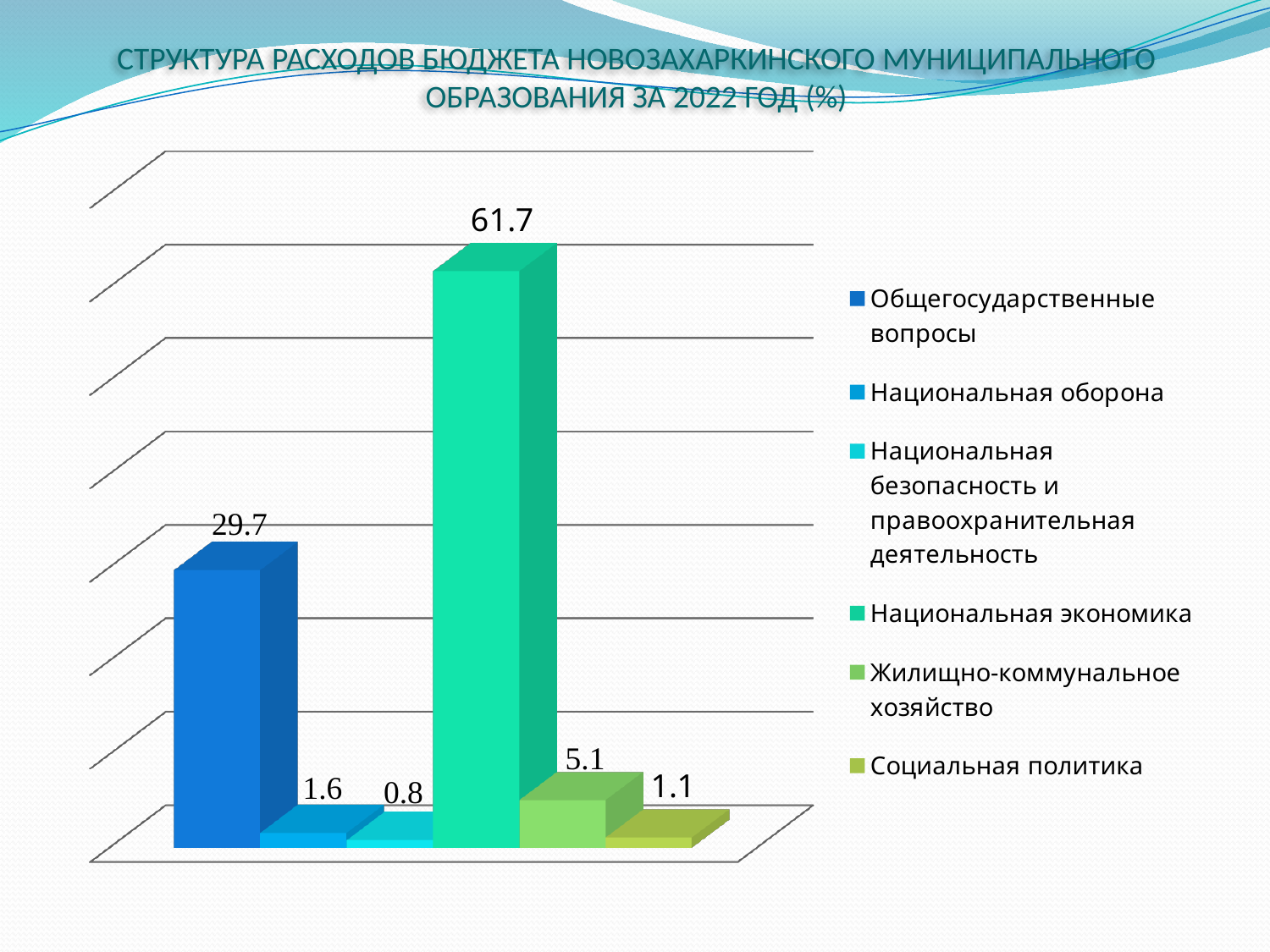
Which is larger, the value for Жилищно-коммунальное хозяйство or the value for Национальная оборона? Жилищно-коммунальное хозяйство What is the value for Общегосударственные вопросы? 29.7 Which category has the highest value? Национальная экономика How many bars are plotted in the chart? 6 What is the value for Жилищно-коммунальное хозяйство? 5.1 What is the difference between the values for Национальная экономика and Общегосударственные вопросы? 32 Which category has the lowest value? Национальная безопасность и правоохранительная деятельность What is the value for Социальная политика? 1.1 How many entries does the legend list? 6 What is the value for Национальная экономика? 61.7 What kind of chart is shown on the slide? Bar chart What is the value for Национальная оборона? 1.6